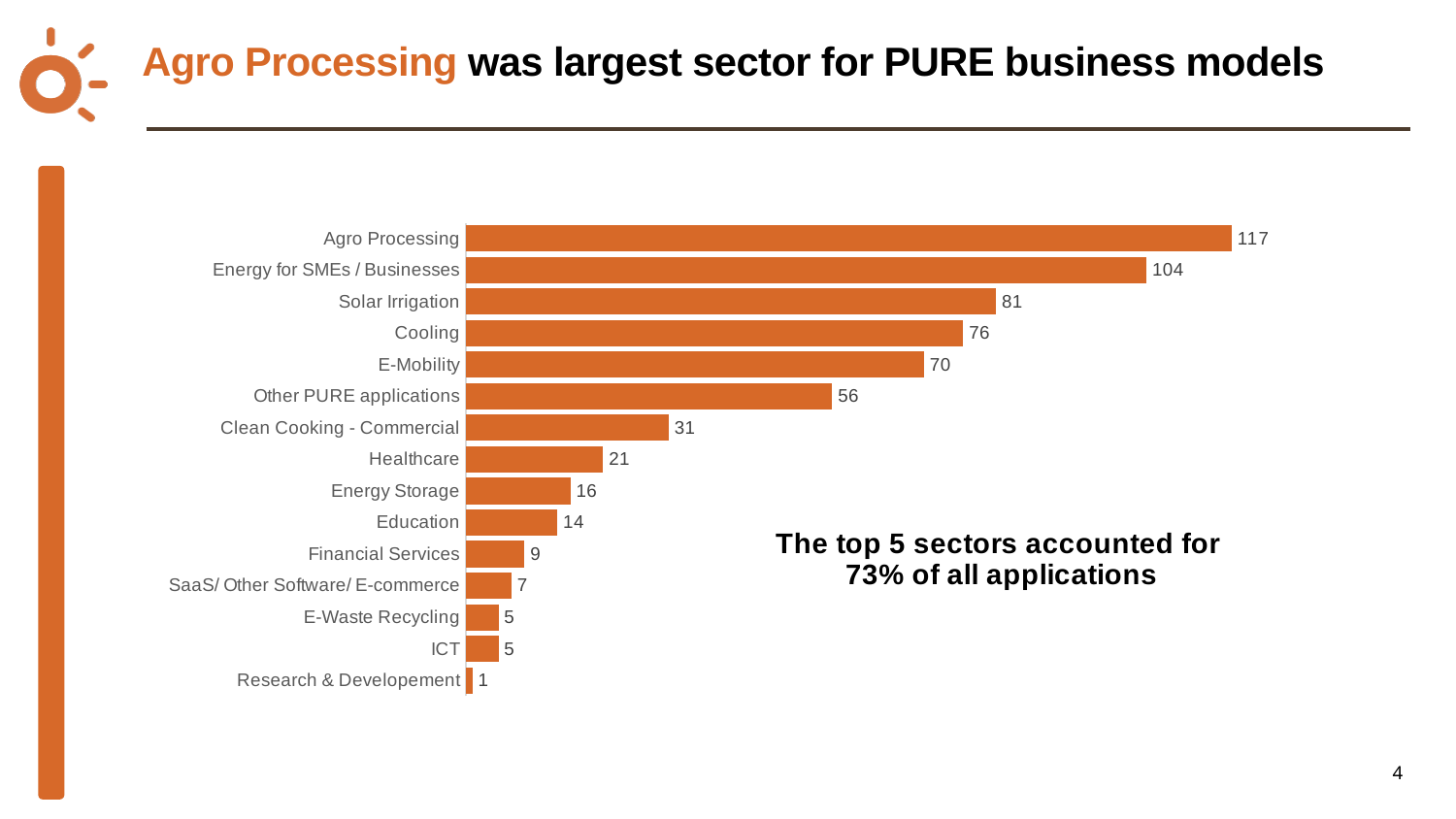
Which is larger, Healthcare or Energy Storage? Healthcare Which is larger, Other PURE applications or Clean Cooking - Commercial? Other PURE applications What is the value for Agro Processing? 117 What is the value for Clean Cooking - Commercial? 31 What is the difference between Cooling and E-Mobility? 6 Which sector has the lowest value? Research & Developement How many sectors are shown in the chart? 15 Which sector has the highest value? Agro Processing According to the text on the slide, what share of all applications did the top 5 sectors account for? 73% What is the difference between Agro Processing and Energy for SMEs / Businesses? 13 What kind of chart is shown on the slide? Bar chart What is the value for Solar Irrigation? 81